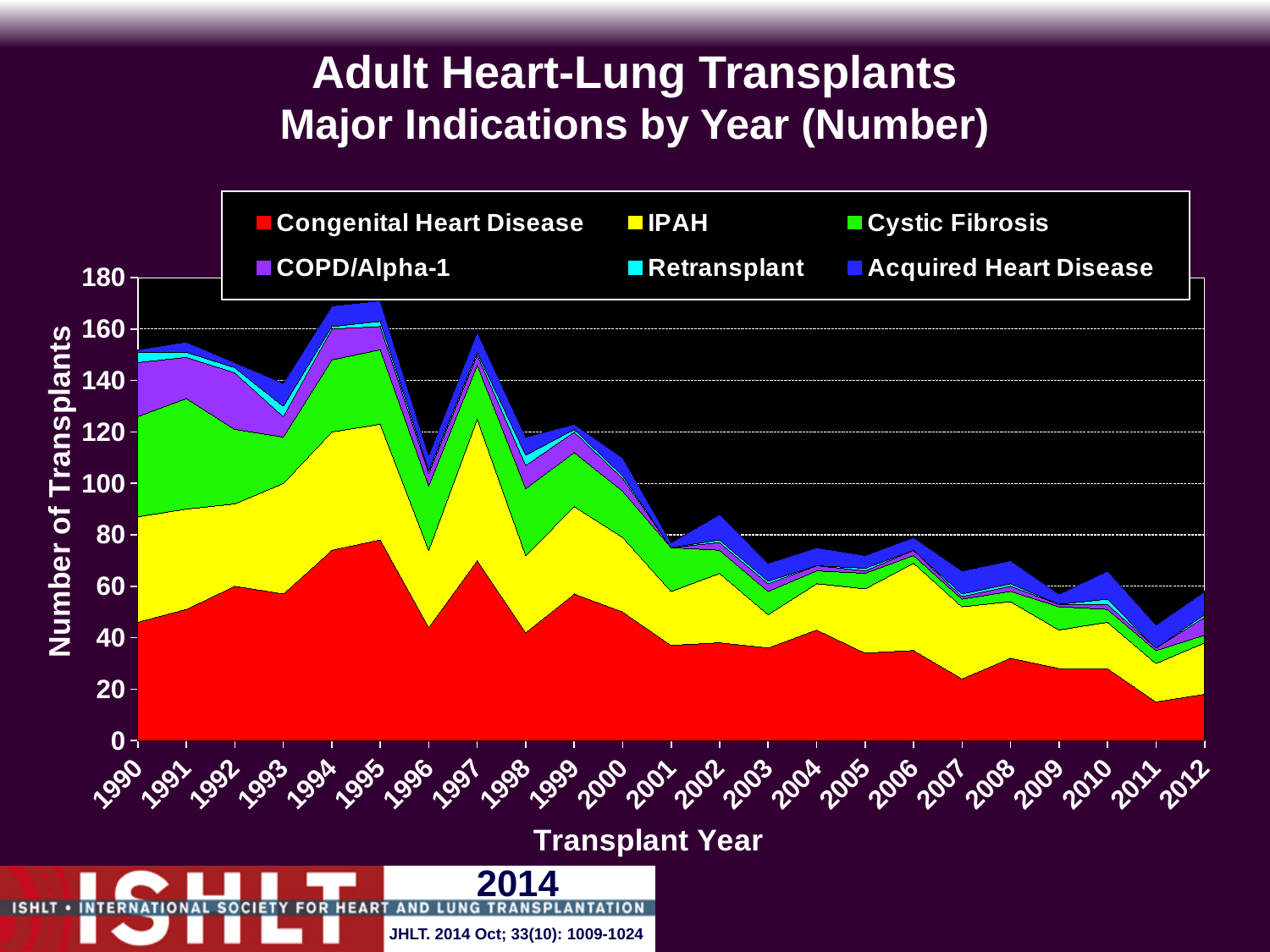
Which year has the lowest total number of transplants? 2011 How many series does the legend list? 6 Is the total number of transplants in 1995 greater or less than 160? greater Is the total number of transplants in 2011 greater or less than 60? less What is the label of the y axis? Number of Transplants Overall, does the total number of transplants rise or fall from 1990 to 2012? fall Which year has the larger total number of transplants, 1990 or 2012? 1990 Is the number of Congenital Heart Disease transplants in 2011 greater or less than 20? less Which indication is shown in yellow in the legend? IPAH How many transplant years are shown along the x axis? 23 What kind of chart is shown on the slide? Stacked area chart